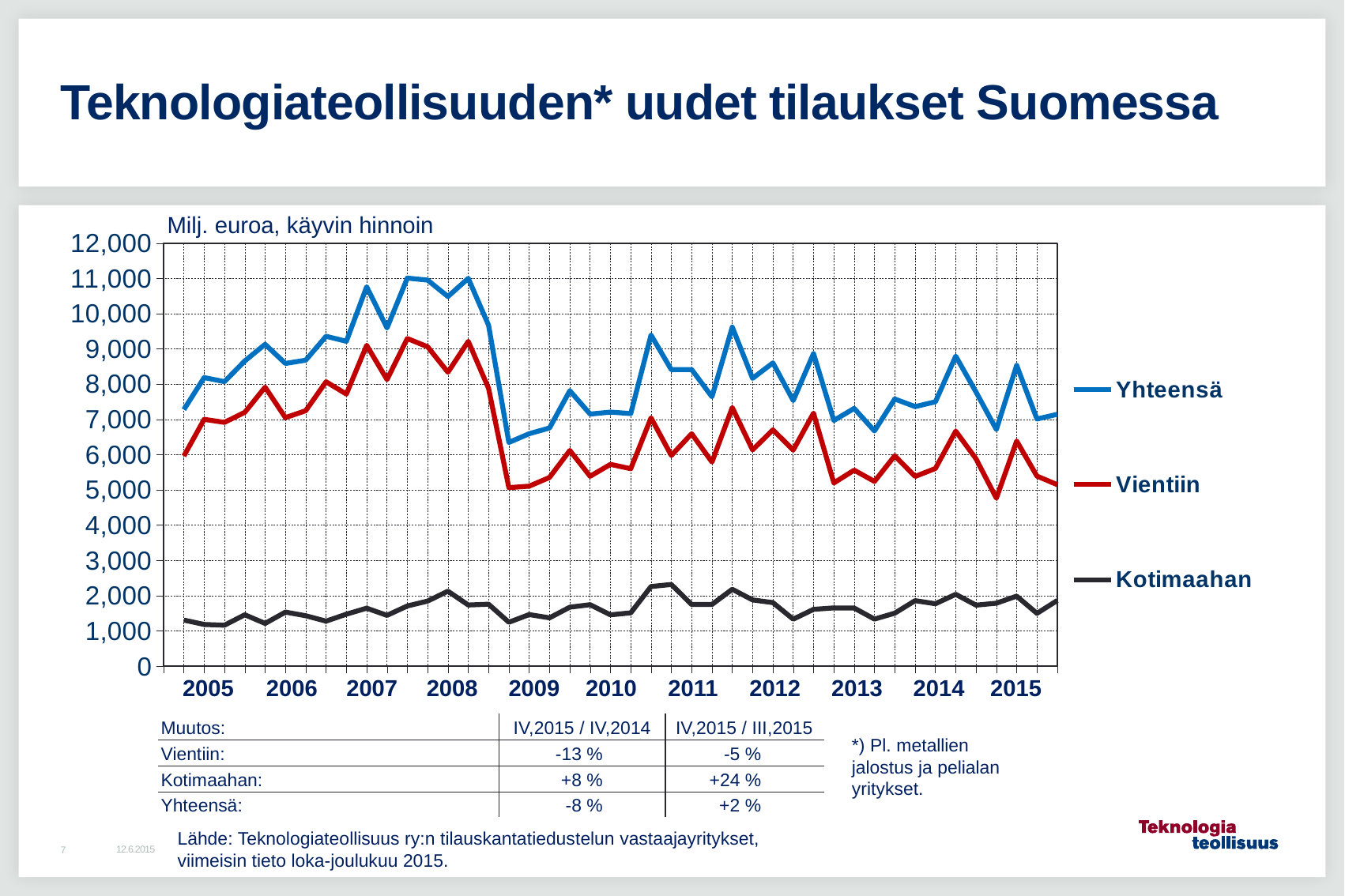
Is the Kotimaahan value at the start of 2005 greater or less than 2,000? less What unit is stated above the chart's y axis? Milj. euroa, käyvin hinnoin Which series has the highest values throughout the chart? Yhteensä Does the Yhteensä series rise or fall between 2008 and 2009? fall Which is larger in 2012, the Yhteensä series or the Vientiin series? Yhteensä What kind of chart is shown on the slide? line chart How many year labels are shown on the x axis? 11 Is the peak value of the Vientiin series in 2007 greater or less than 8,000? greater Which series are listed in the legend? Yhteensä, Vientiin, Kotimaahan Is the peak value of the Yhteensä series around 2007–2008 greater or less than 10,000? greater Which series has the lowest values throughout the chart? Kotimaahan How many series does the legend list? 3